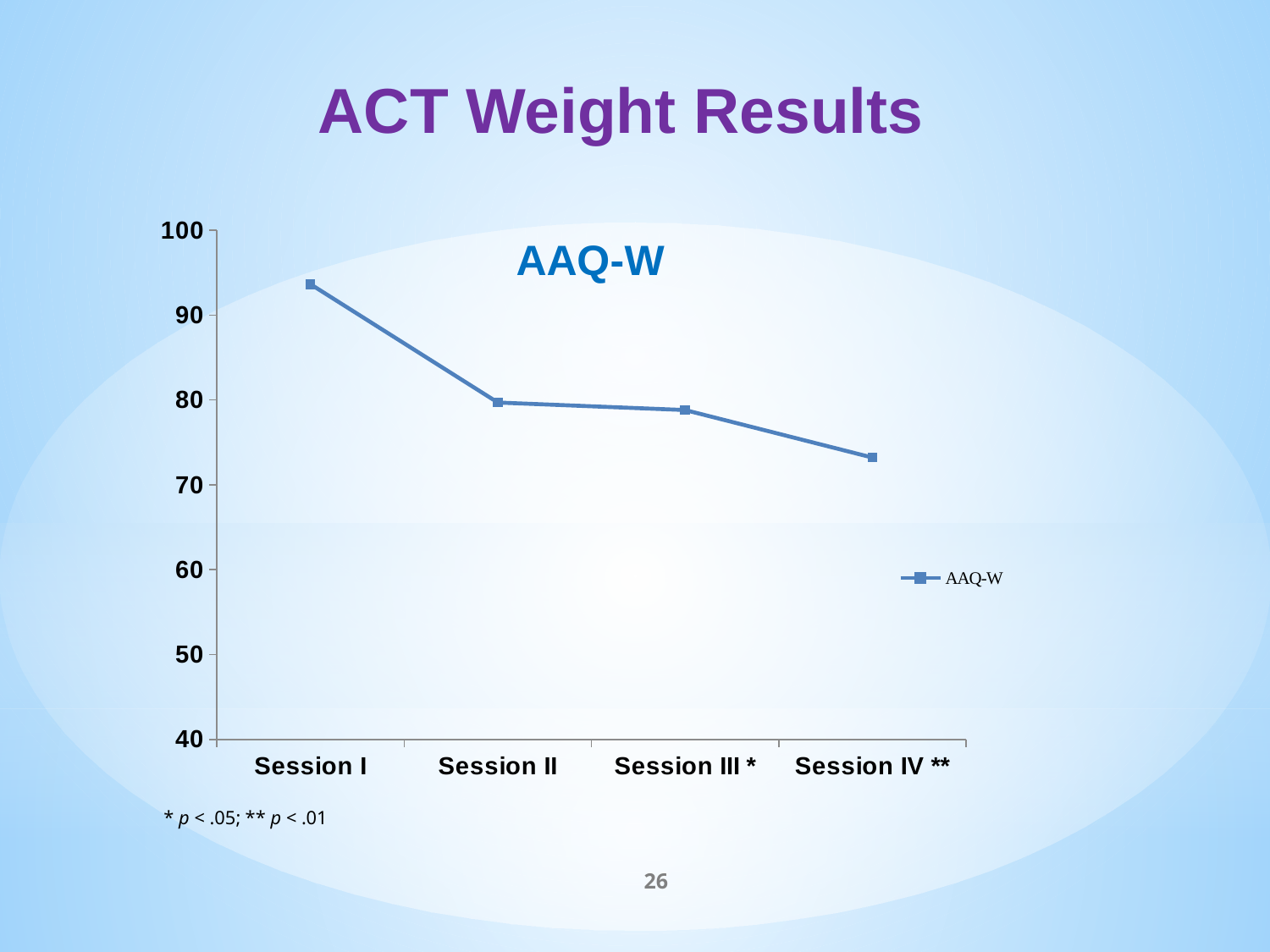
What is the name of the series shown in the legend? AAQ-W Is the AAQ-W value for Session IV ** greater or less than 70? greater Which has the larger AAQ-W value, Session I or Session IV **? Session I Which session has the highest AAQ-W value? Session I How many series does the legend list? 1 How many sessions are plotted along the x axis? 4 Do the AAQ-W values rise or fall from Session I to Session IV? fall What is the title of the chart? AAQ-W Is the AAQ-W value for Session IV ** greater or less than 80? less What kind of chart is shown on the slide? line chart Which session has the lowest AAQ-W value? Session IV ** Is the AAQ-W value for Session I greater or less than 90? greater